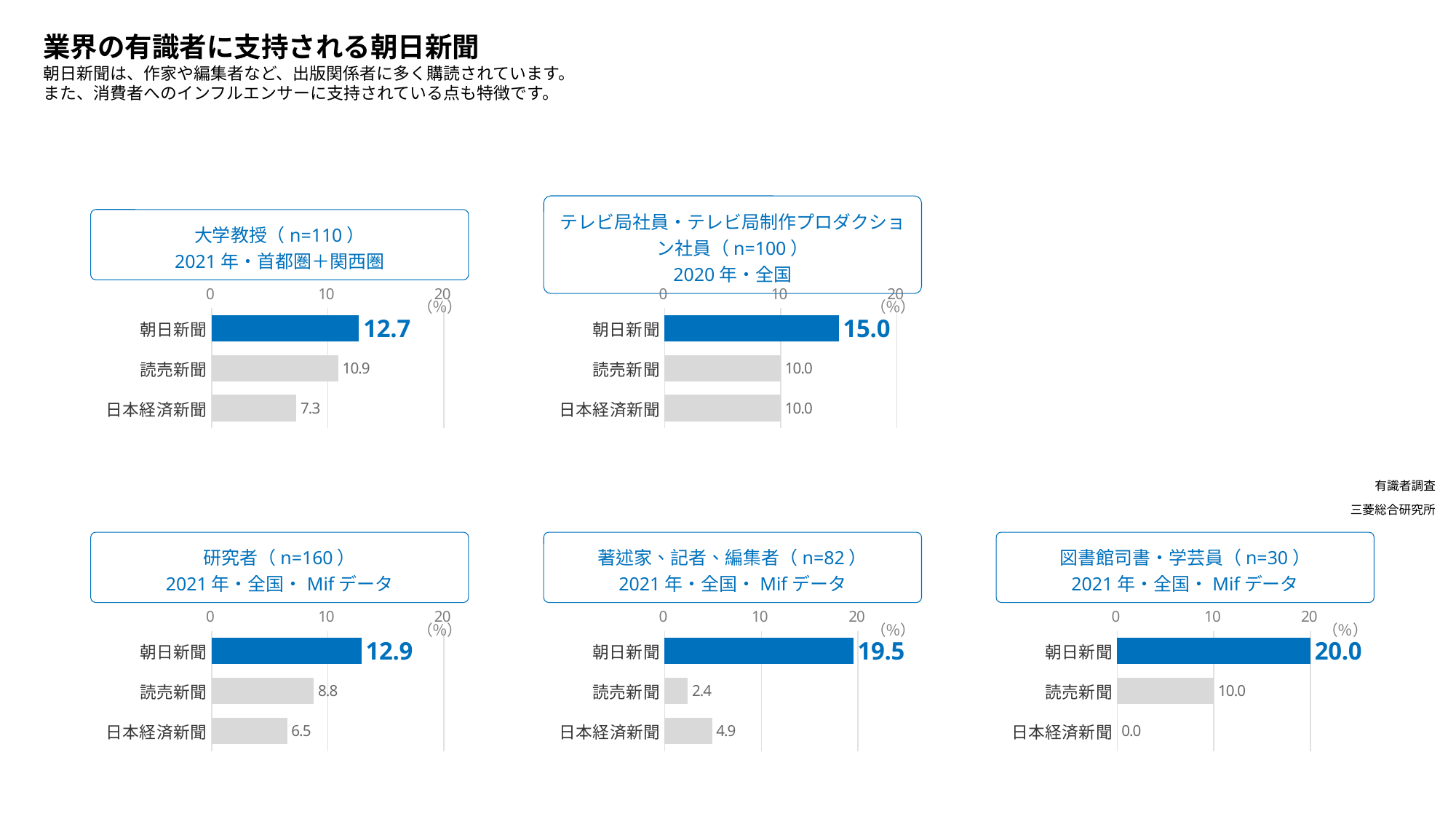
In the 図書館司書・学芸員 (n=30) chart, what is the difference between 朝日新聞 and 読売新聞? 10.0 In the 図書館司書・学芸員 (n=30) chart, what is the value for 日本経済新聞? 0.0 In the 著述家、記者、編集者 (n=82) chart, which is larger, 読売新聞 or 日本経済新聞? 日本経済新聞 In the 研究者 (n=160) chart, which newspaper has the lowest value? 日本経済新聞 In the 研究者 (n=160) chart, what is the value for 読売新聞? 8.8 In the 著述家、記者、編集者 (n=82) chart, what is the value for 朝日新聞? 19.5 In the 大学教授 (n=110) chart, what is the value for 日本経済新聞? 7.3 How many newspapers are shown in the 大学教授 (n=110) chart? 3 In the 大学教授 (n=110) chart, what is the value for 朝日新聞? 12.7 What type of chart is the 研究者 (n=160) chart? bar chart In the テレビ局社員・テレビ局制作プロダクション社員 (n=100) chart, what is the difference between 朝日新聞 and 読売新聞? 5.0 In the テレビ局社員・テレビ局制作プロダクション社員 (n=100) chart, what is the value for 朝日新聞? 15.0